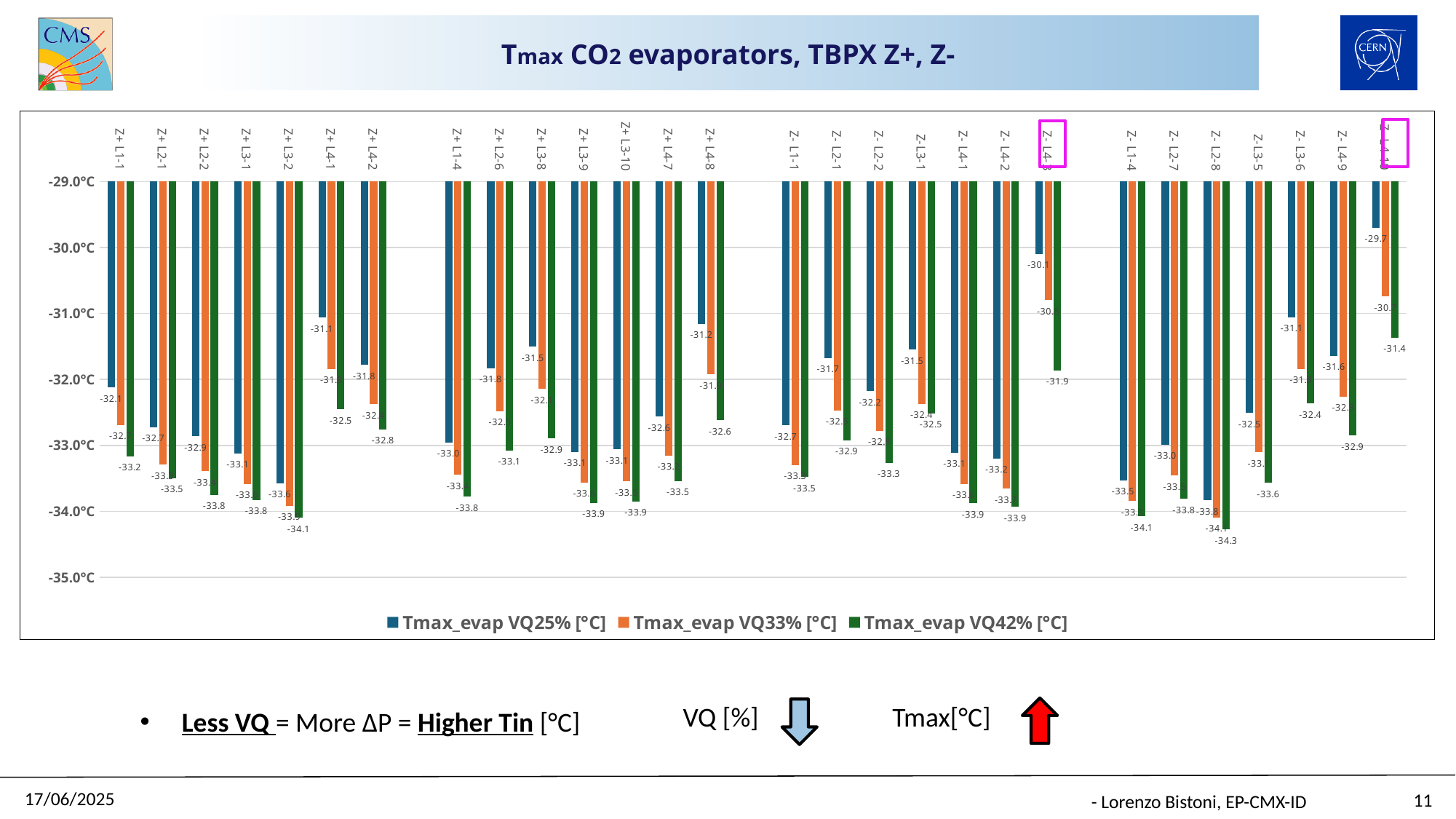
How many series does the legend list? 3 What is the difference between the Tmax_evap VQ25% and VQ42% values for Z+ L3-2? 0.5 Which is higher, the Tmax_evap VQ25% value for Z+ L4-1 or for Z+ L1-1? Z+ L4-1 Is the Tmax_evap VQ25% value for Z+ L4-8 greater or less than -32.0°C? greater Which category has the lowest Tmax_evap VQ42% value? Z- L2-8 What is the Tmax_evap VQ25% value for Z+ L3-2? -33.6 What kind of chart is shown on the slide? bar chart What is the Tmax_evap VQ25% value for Z+ L4-1? -31.1 Which series is shown in green in the legend? Tmax_evap VQ42% [°C] What is the Tmax_evap VQ42% value for Z+ L3-2? -34.1 Is the Tmax_evap VQ42% value for Z- L2-8 greater or less than -34.0°C? less What is the Tmax_evap VQ42% value for Z- L2-8? -34.3